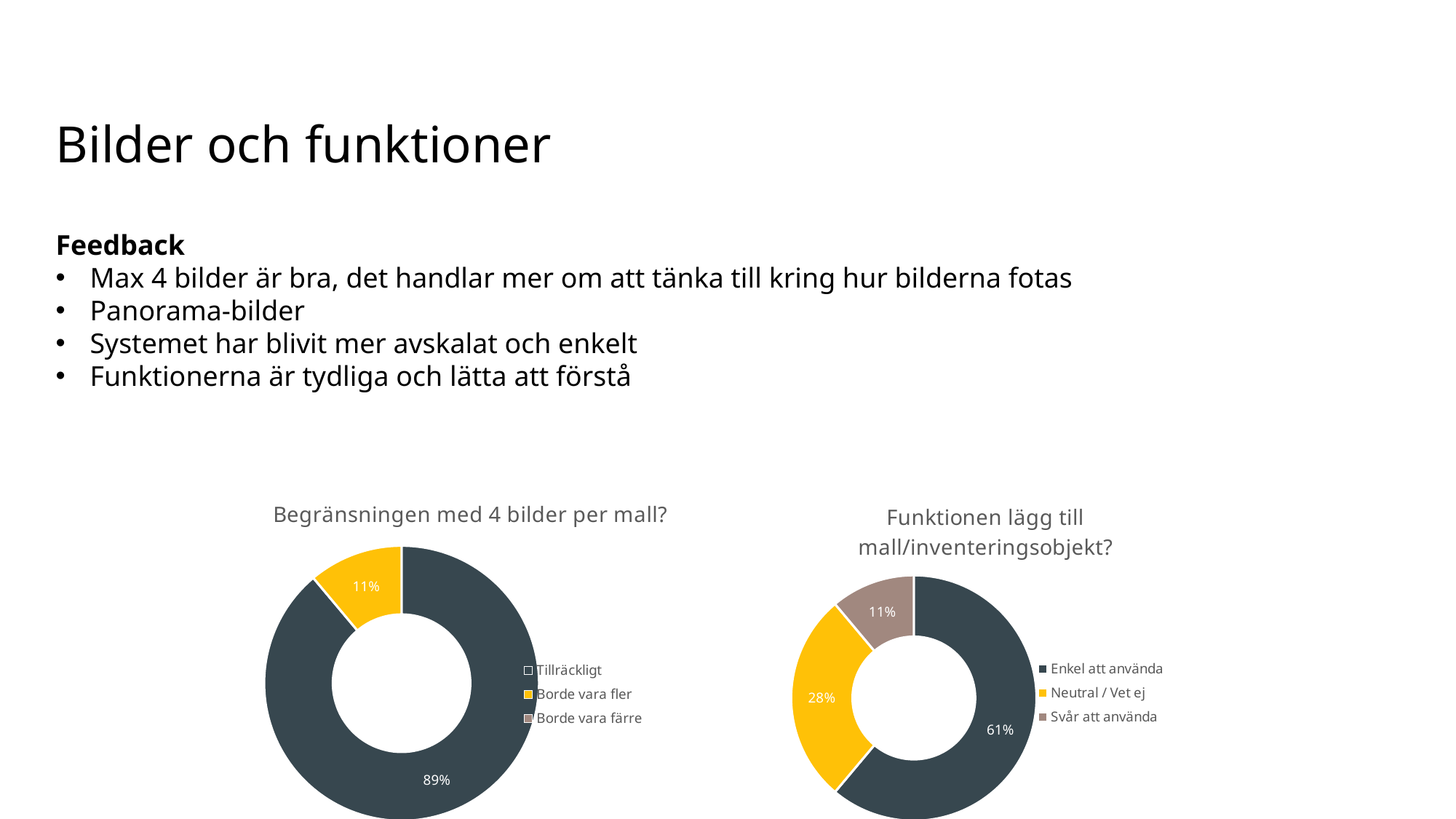
In the chart titled 'Funktionen lägg till mall/inventeringsobjekt?', which category has the smallest slice? Svår att använda In the chart titled 'Begränsningen med 4 bilder per mall?', what share is labelled for 'Tillräckligt'? 89% What kind of chart is the one titled 'Funktionen lägg till mall/inventeringsobjekt?'? Doughnut (pie) chart In the chart titled 'Funktionen lägg till mall/inventeringsobjekt?', what share is labelled for 'Svår att använda'? 11% How many entries does the legend of the chart titled 'Begränsningen med 4 bilder per mall?' list? 3 In the chart titled 'Begränsningen med 4 bilder per mall?', what share is labelled for 'Borde vara fler'? 11% In the chart titled 'Funktionen lägg till mall/inventeringsobjekt?', which is larger: 'Neutral / Vet ej' or 'Svår att använda'? Neutral / Vet ej In the chart titled 'Funktionen lägg till mall/inventeringsobjekt?', what is the difference between 'Enkel att använda' and 'Neutral / Vet ej'? 33% In the chart titled 'Funktionen lägg till mall/inventeringsobjekt?', what share is labelled for 'Enkel att använda'? 61% In the chart titled 'Funktionen lägg till mall/inventeringsobjekt?', what share is labelled for 'Neutral / Vet ej'? 28% In the chart titled 'Begränsningen med 4 bilder per mall?', what is the difference between the 'Tillräckligt' and 'Borde vara fler' shares? 78% In the chart titled 'Begränsningen med 4 bilder per mall?', which category has the largest slice? Tillräckligt